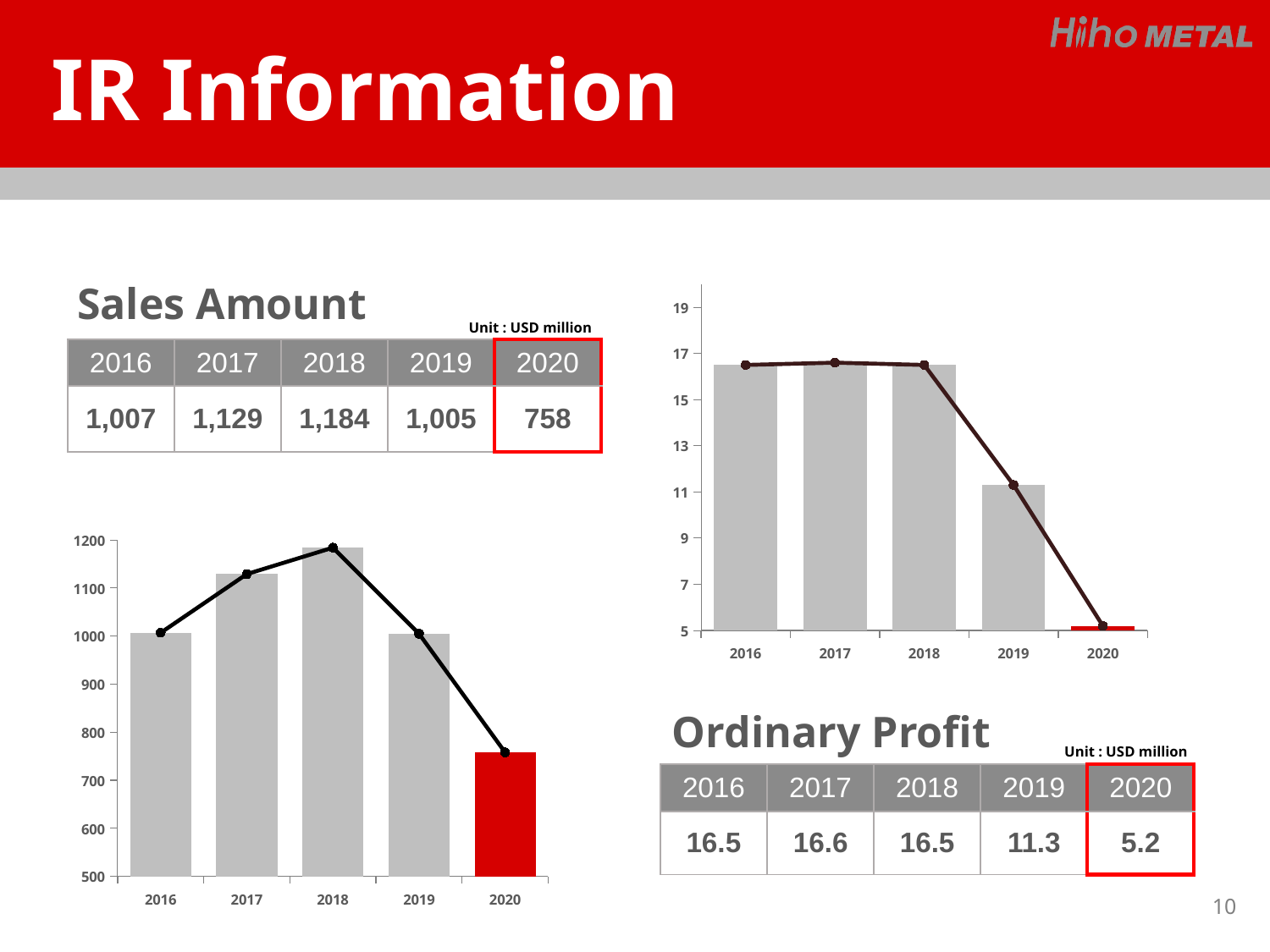
In the Sales Amount chart, what is the sales amount for 2018? 1,184 In the Sales Amount chart, which year has the lowest sales amount? 2020 In the Ordinary Profit chart, is the ordinary profit for 2018 larger than for 2019? Yes How many years are shown in the Ordinary Profit chart? 5 In the Ordinary Profit chart, what is the ordinary profit for 2019? 11.3 In the Ordinary Profit chart, what is the difference between the 2019 and 2020 ordinary profit values? 6.1 In the Sales Amount chart, which year has the highest sales amount? 2018 In the Sales Amount chart, what is the sales amount for 2020? 758 In the Ordinary Profit chart, which year has the lowest ordinary profit? 2020 In the Sales Amount chart, is the value for 2020 greater or less than 800? less In the Sales Amount chart, what is the difference between the 2018 and 2020 sales amounts? 426 In the Sales Amount chart, do the values rise or fall from 2018 to 2020? fall